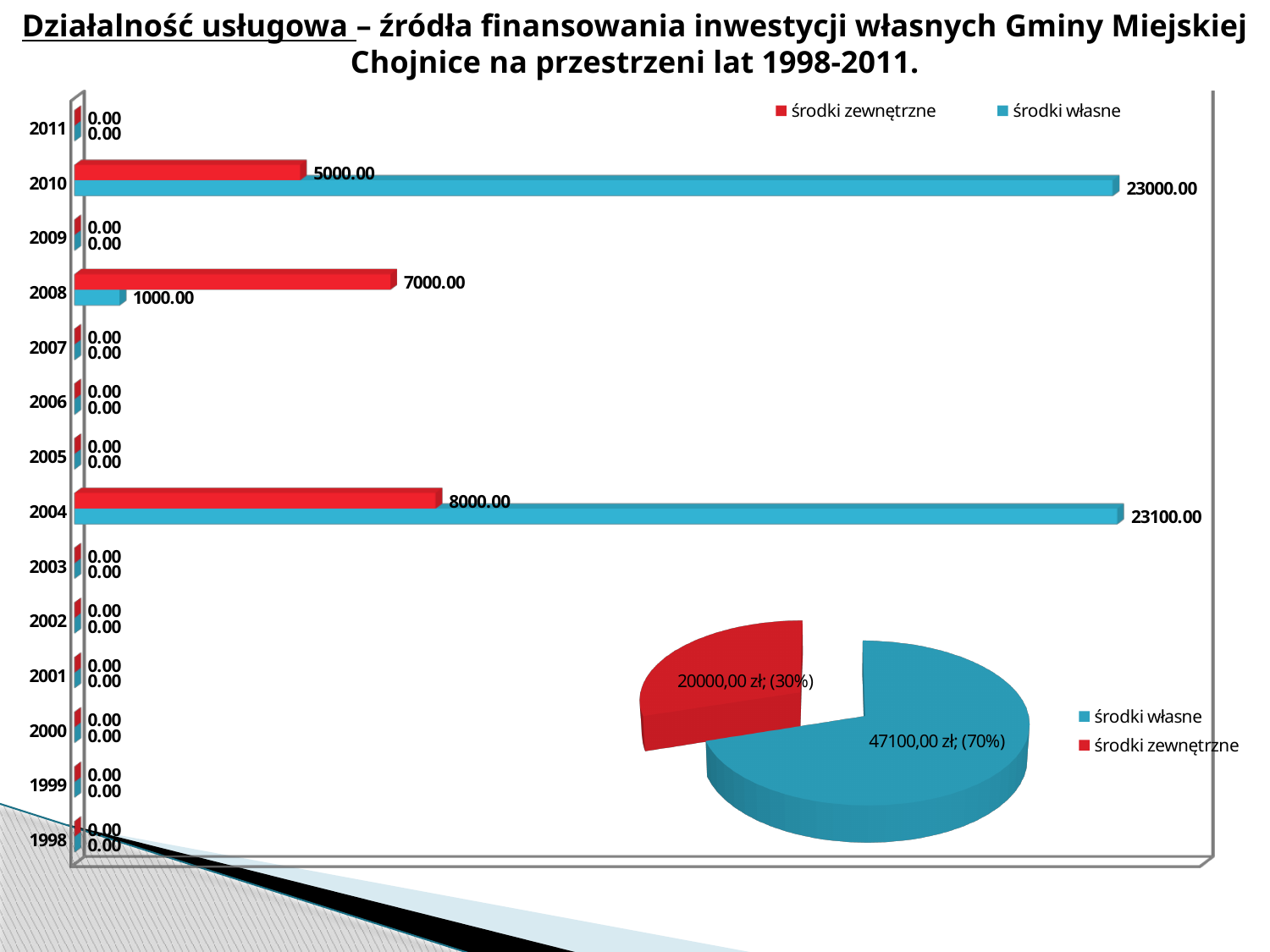
In the bar chart, what is the value of środki własne for 2004? 23100.00 How many years are shown on the bar chart? 14 In the bar chart, what is the difference between środki własne and środki zewnętrzne in 2004? 15100.00 In the bar chart, what is the value of środki własne for 2010? 23000.00 In the pie chart, what share does środki własne have? 70% In the bar chart, what is the total of środki własne and środki zewnętrzne for 2010? 28000.00 In the bar chart, what is the value of środki zewnętrzne for 2008? 7000.00 In the pie chart, what is the value shown for środki zewnętrzne? 20000,00 zł How many series does the bar chart's legend list? 2 In the bar chart, which is larger in 2008: środki własne or środki zewnętrzne? środki zewnętrzne In the bar chart, which year has the highest value for środki zewnętrzne? 2004 What kind of chart is the chart showing values by year? bar chart